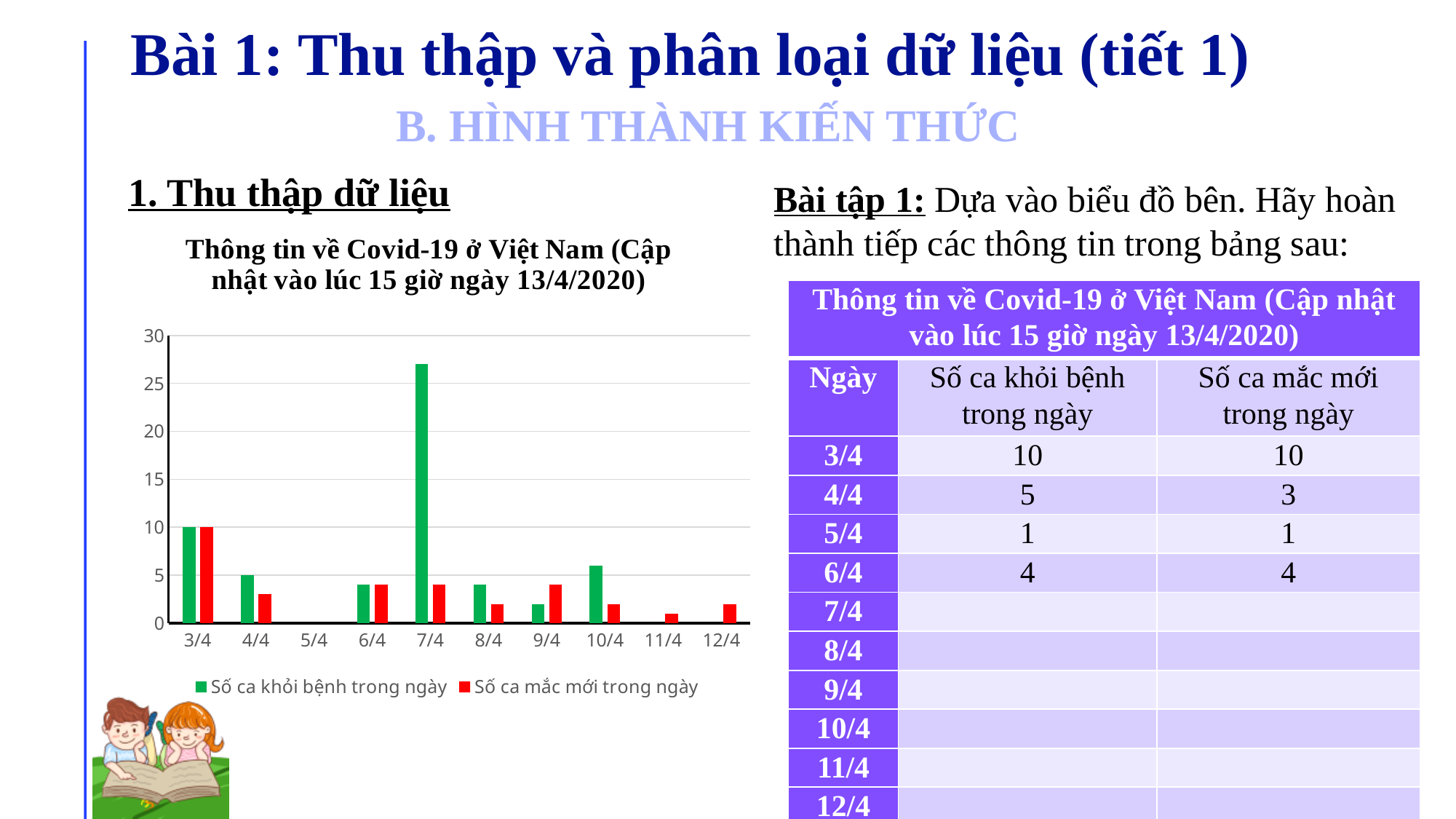
On 9/4, which series has the larger value: 'Số ca khỏi bệnh trong ngày' or 'Số ca mắc mới trong ngày'? Số ca mắc mới trong ngày On which date is 'Số ca khỏi bệnh trong ngày' highest? 7/4 On which date is 'Số ca mắc mới trong ngày' highest? 3/4 What is the value of 'Số ca mắc mới trong ngày' on 3/4? 10 What is the difference between 'Số ca khỏi bệnh trong ngày' on 3/4 and on 4/4? 5 What kind of chart is shown on the slide? bar chart How many series does the chart legend list? 2 Is the value for 'Số ca khỏi bệnh trong ngày' on 7/4 greater or less than 25? greater How many dates are shown on the x axis of the chart? 10 What is the value of 'Số ca khỏi bệnh trong ngày' on 3/4? 10 What is the value of 'Số ca khỏi bệnh trong ngày' on 4/4? 5 Is the value for 'Số ca mắc mới trong ngày' on 8/4 greater or less than 5? less